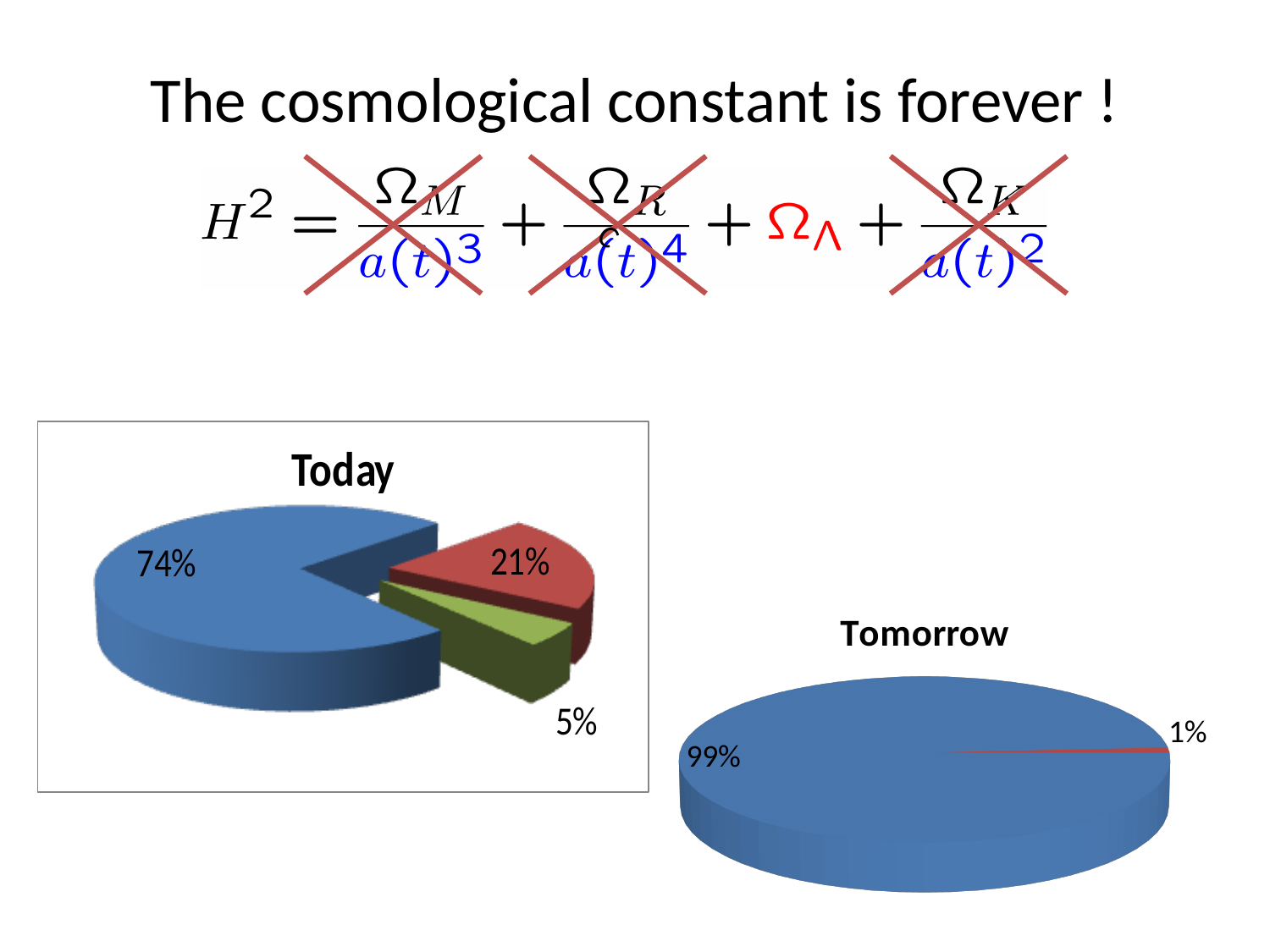
In the "Tomorrow" chart, what share does the blue slice have? 99% In the "Today" chart, what share does the red slice have? 21% What kind of chart is the "Tomorrow" chart? pie chart What kind of chart is the "Today" chart? pie chart How many slices does the "Today" pie chart have? 3 How many slices does the "Tomorrow" pie chart have? 2 In the "Tomorrow" chart, what share does the red slice have? 1% In the "Today" chart, which slice is the smallest? the green slice (5%) In the "Today" chart, what is the difference between the blue slice and the red slice? 53% In the "Today" chart, which slice is the largest? the blue slice (74%)